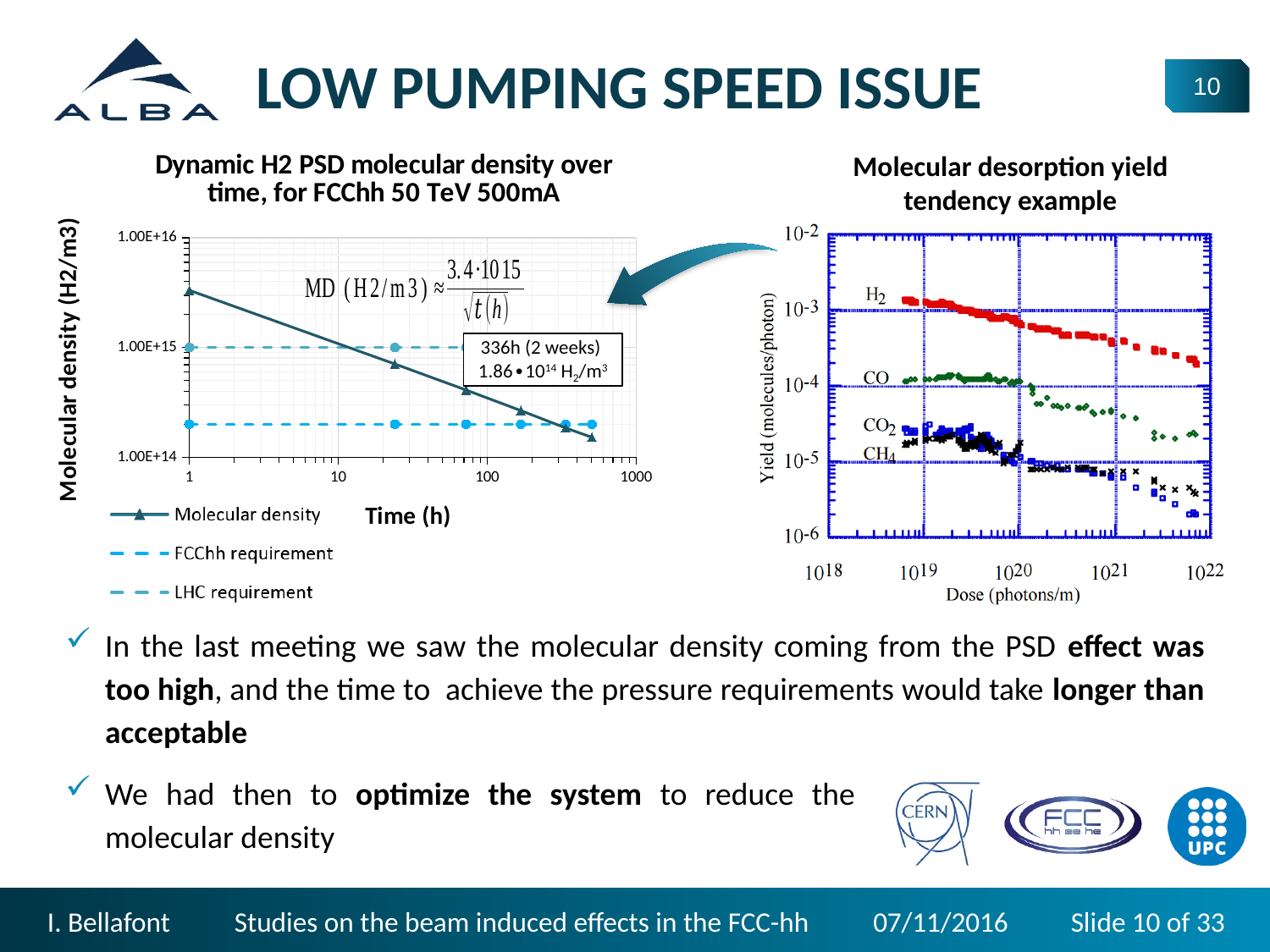
In the right chart ('Molecular desorption yield tendency example'), does the H2 yield rise or fall as the dose increases? falls In the right chart ('Molecular desorption yield tendency example'), what is the label of the x axis? Dose (photons/m) How many series does the legend of the left chart ('Dynamic H2 PSD molecular density over time') list? 3 In the left chart ('Dynamic H2 PSD molecular density over time'), what molecular density value is given in the annotation for 336h (2 weeks)? 1.86•10^14 H2/m3 In the left chart ('Dynamic H2 PSD molecular density over time'), what are the three legend entries? Molecular density, FCChh requirement, LHC requirement In the right chart ('Molecular desorption yield tendency example'), how many molecules are plotted? 4 In the left chart ('Dynamic H2 PSD molecular density over time'), does the molecular density rise or fall as time increases? falls What kind of chart is the 'Dynamic H2 PSD molecular density over time' chart on the left? line chart In the right chart ('Molecular desorption yield tendency example'), which molecule has the highest yield? H2